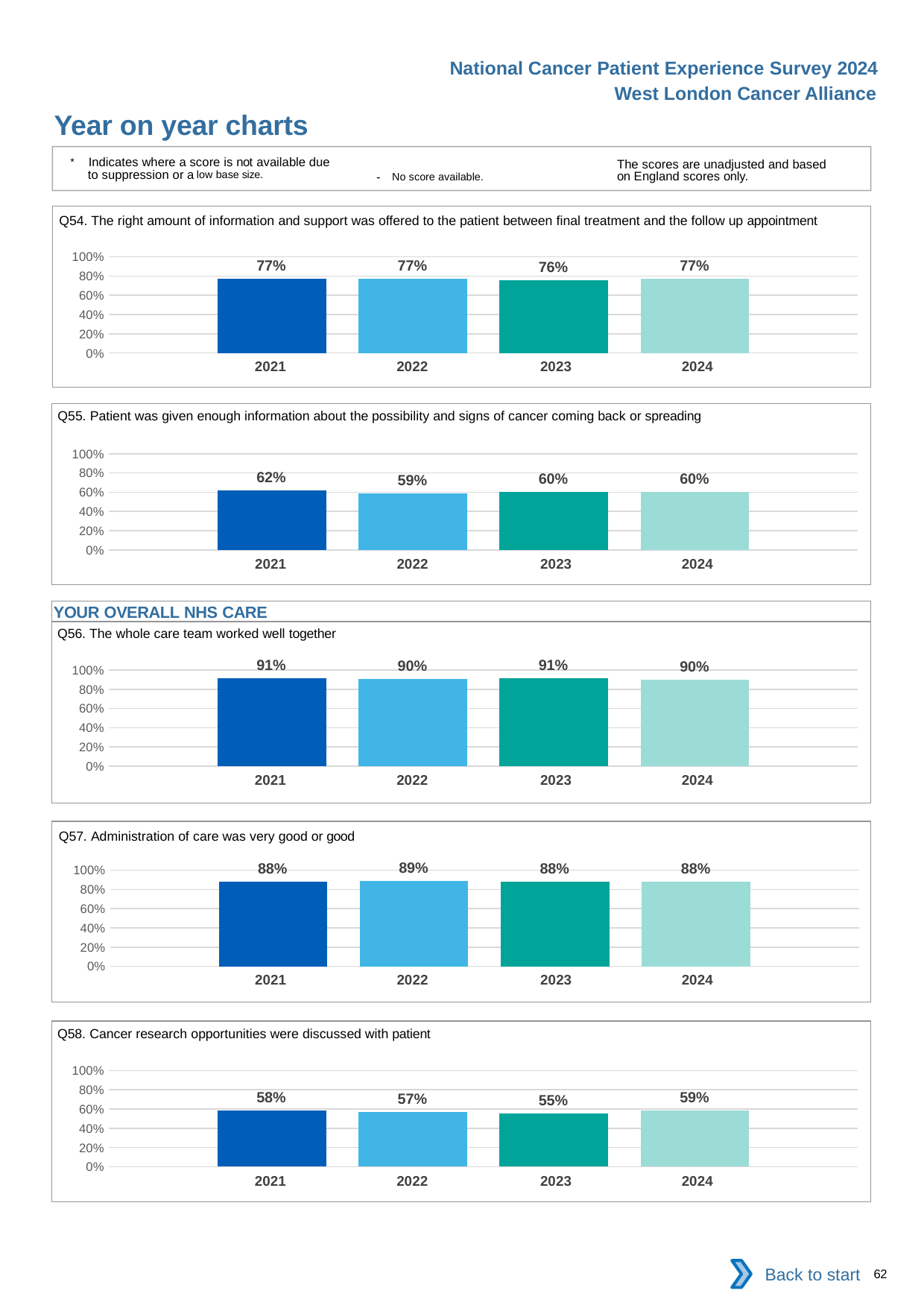
In the Q55 chart, is the value for 2024 greater or less than 80%? less In the Q55 chart, what is the difference between the 2021 and 2022 values? 3 percentage points In the Q58 chart, is the value for 2021 larger or smaller than the value for 2022? larger What kind of chart is the Q57 chart? bar chart In the Q58 chart, what is the difference between the 2024 and 2023 values? 4 percentage points In the Q56 chart, what is the value for 2024? 90% In the Q58 chart, which year has the lowest value? 2023 In the Q57 chart, which year has the highest value? 2022 In the Q55 chart, which year has the highest value? 2021 In the Q54 chart, what is the value for 2023? 76% What is the section heading shown above the Q56 chart? YOUR OVERALL NHS CARE How many years are shown in the Q54 chart? 4